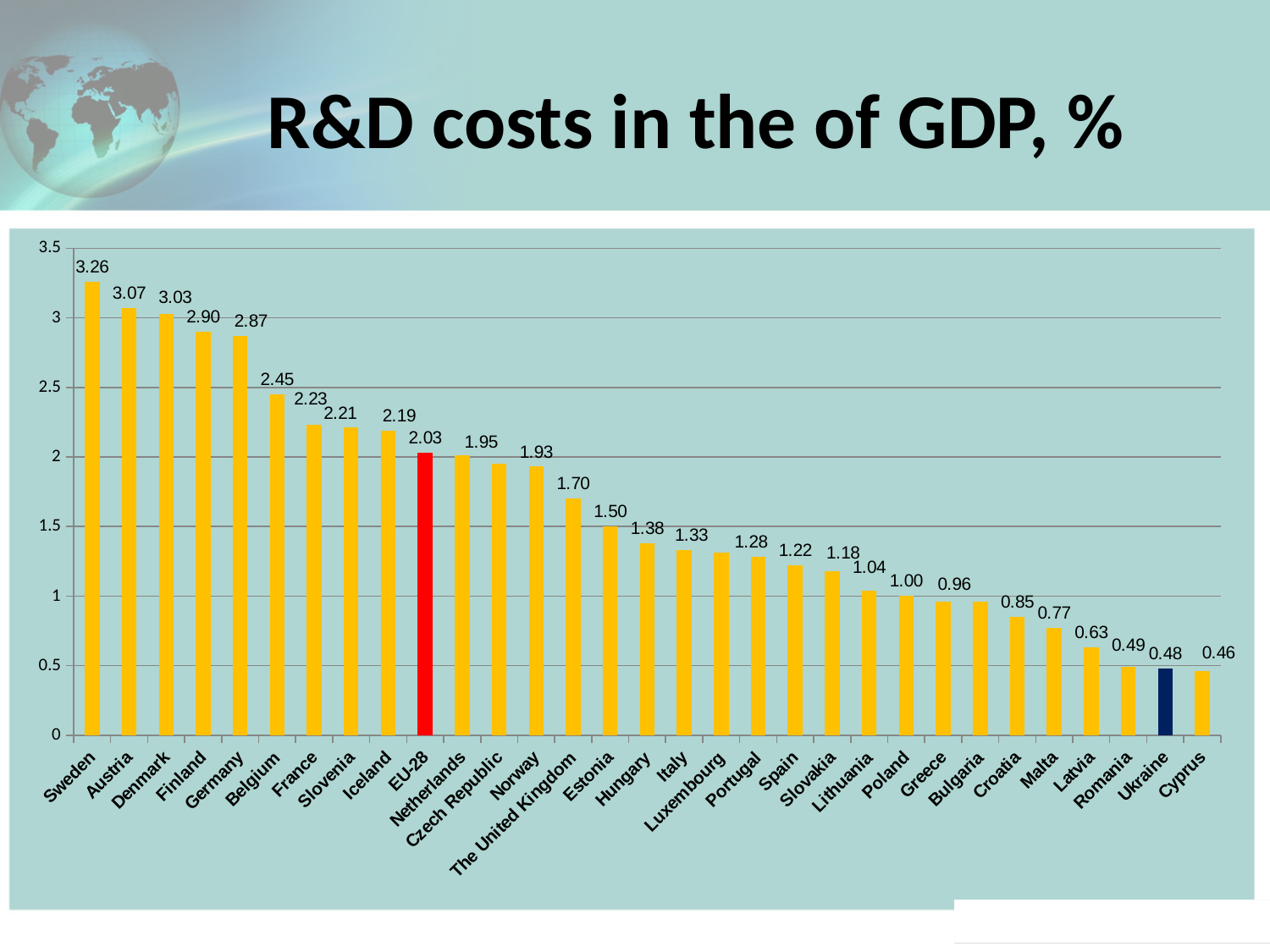
Which category has the highest value? Sweden What colour is the bar for EU-28? red How many categories are shown on the x axis? 31 What is the value for Ukraine? 0.48 What is the value for Belgium? 2.45 What is the value for Sweden? 3.26 Is the value for Norway greater or less than 1.5? greater What is the value for EU-28? 2.03 Which is larger, the value for Belgium or the value for France? Belgium Which category has the lowest value? Cyprus What kind of chart is shown on the slide? bar chart What is the difference between the values for Sweden and EU-28? 1.23